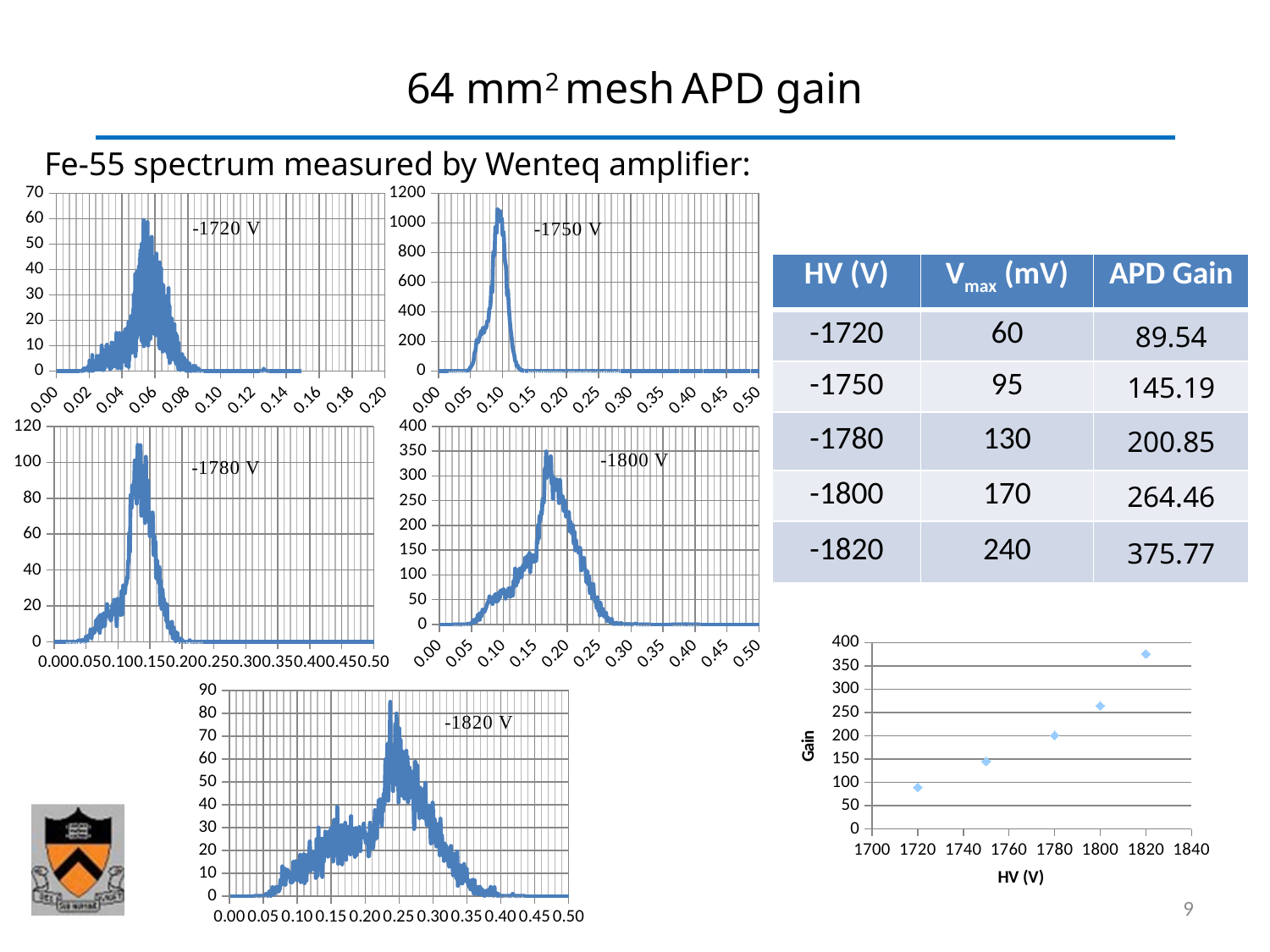
In the Gain versus HV (V) scatter chart, does the gain rise or fall as HV increases along the x axis? rise What is the y-axis title of the Gain versus HV (V) scatter chart? Gain In the Gain versus HV (V) scatter chart, which HV value has the highest gain? 1820 In the Gain versus HV (V) scatter chart, is the gain at HV 1820 greater or less than 350? greater How many Fe-55 spectrum charts are shown on the slide? 5 In the -1800 V spectrum chart, is the peak height greater or less than 300? greater What kind of chart is the Gain versus HV (V) chart at the bottom right of the slide? scatter chart In the Gain versus HV (V) scatter chart, which HV value has the lowest gain? 1720 In the -1750 V spectrum chart, is the peak height greater or less than 1000? greater How many data points are plotted in the Gain versus HV (V) scatter chart? 5 In the Gain versus HV (V) scatter chart, is the gain at HV 1800 larger or smaller than the gain at HV 1780? larger